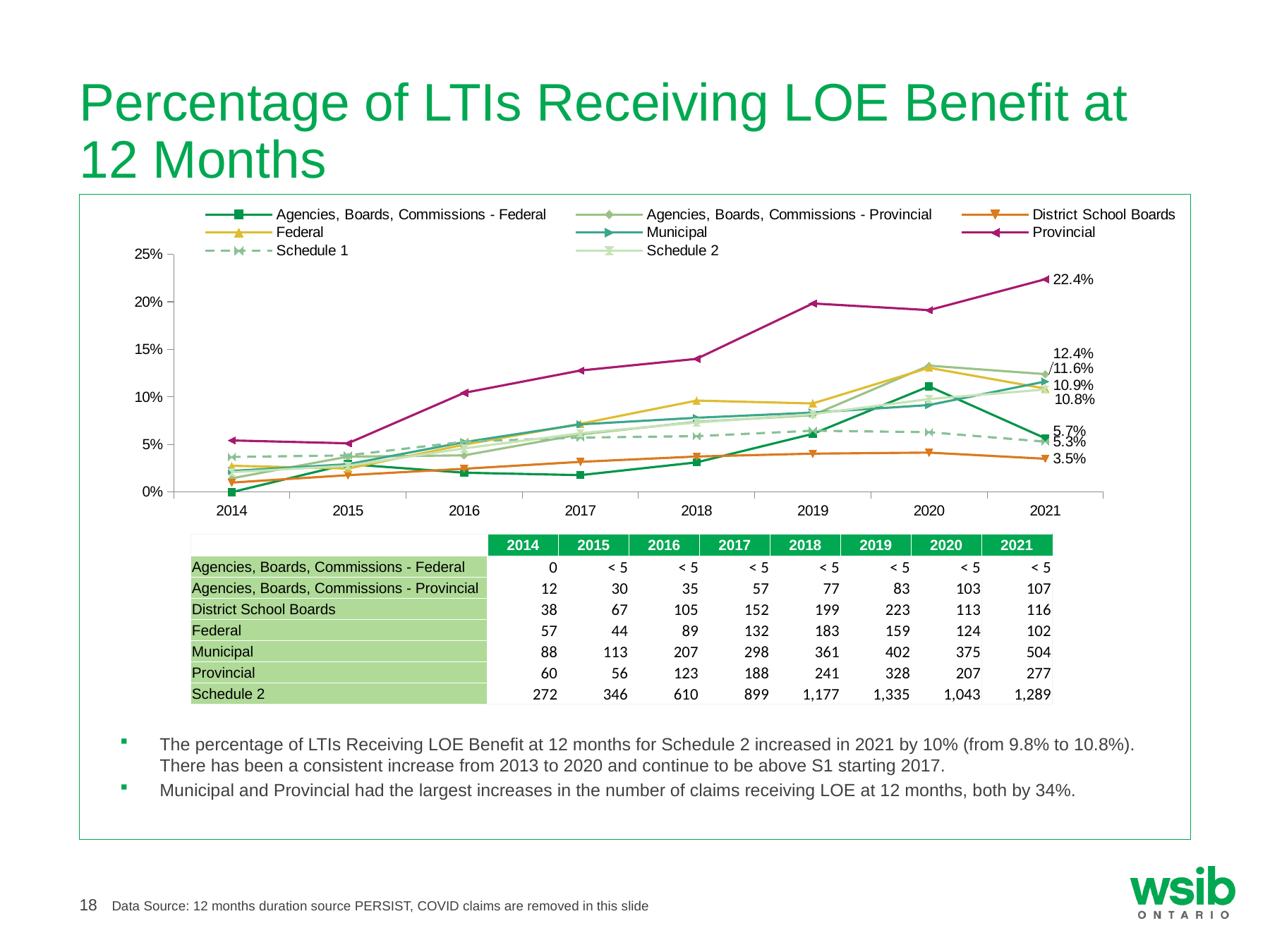
Is the value for Provincial in 2014 greater or less than 10%? less Is the value for Provincial in 2019 greater or less than 15%? greater Which series is drawn with a dashed line in the chart? Schedule 1 How many years are plotted along the x axis of the chart? 8 Which series has the highest value in 2021? Provincial What is the difference between the Provincial and District School Boards values in 2021? 18.9% Does the Provincial line generally rise or fall from 2014 to 2021? rise What is the value for District School Boards in 2021? 3.5% Which series has the lowest value in 2021? District School Boards How many series does the chart legend list? 8 What is the value for Provincial in 2021? 22.4% What type of chart is shown on the slide? line chart